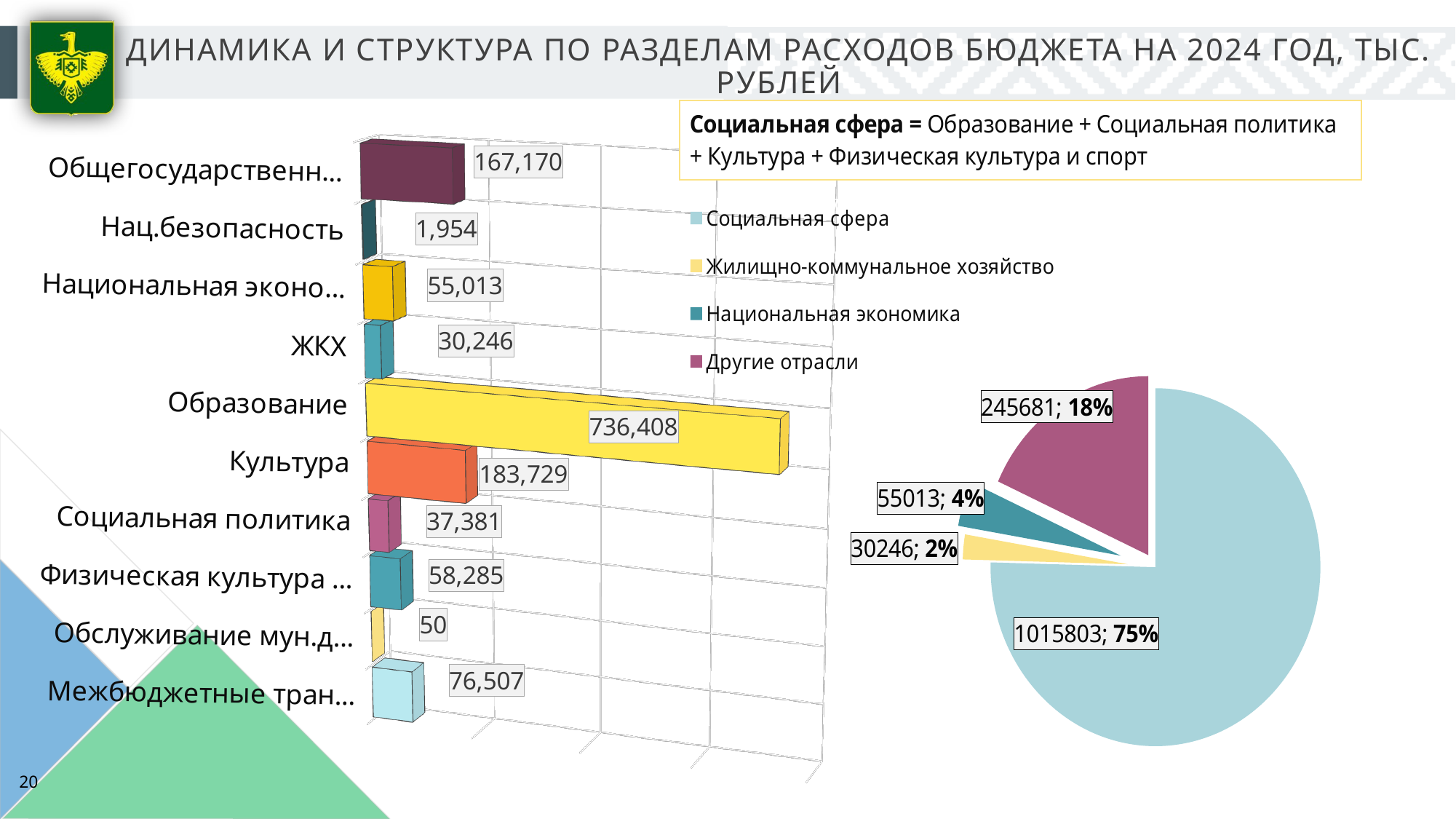
In the bar chart on the left, what is the difference between the values for Культура and Социальная политика? 146,348 In the bar chart on the left, which is larger: the value for Нац.безопасность or the value for ЖКХ? ЖКХ In the pie chart on the right, what share does Социальная сфера have? 75% In the bar chart on the left, which category has the lowest value? Обслуживание мун.д... In the bar chart on the left, what is the value for Образование? 736,408 In the bar chart on the left, which category has the highest value? Образование In the bar chart on the left, what is the value for ЖКХ? 30,246 What kind of chart is the chart on the left of the slide? Bar chart How many entries does the legend of the pie chart on the right list? 4 In the bar chart on the left, what is the value for Культура? 183,729 In the pie chart on the right, what is the value shown for Другие отрасли? 245681 How many categories does the bar chart on the left show? 10